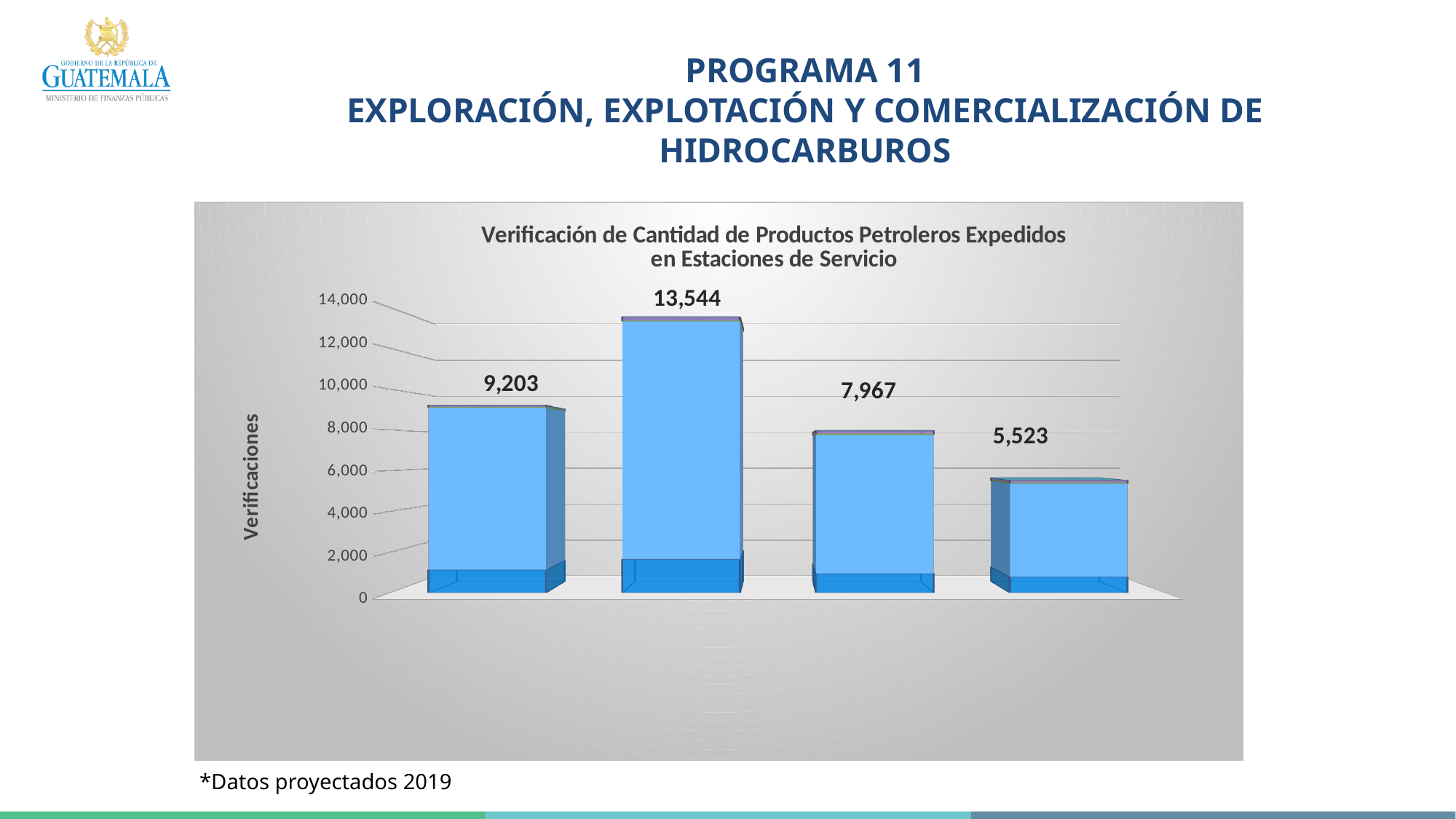
How many bars are plotted in the chart? 4 What is the difference between the highest and lowest values in the chart? 8,021 What is the value of the first (leftmost) bar in the chart? 9,203 What is the label of the vertical axis of the chart? Verificaciones Which bar has the highest value in the chart? The second bar from the left (13,544) Which bar has the lowest value in the chart? The fourth (rightmost) bar (5,523) What is the value of the second bar from the left in the chart? 13,544 What is the difference between the first bar (9,203) and the third bar (7,967)? 1,236 Which is larger, the first bar or the third bar? The first bar (9,203) What is the value of the fourth (rightmost) bar in the chart? 5,523 What is the value of the third bar from the left in the chart? 7,967 What type of chart is shown on the slide? Bar chart